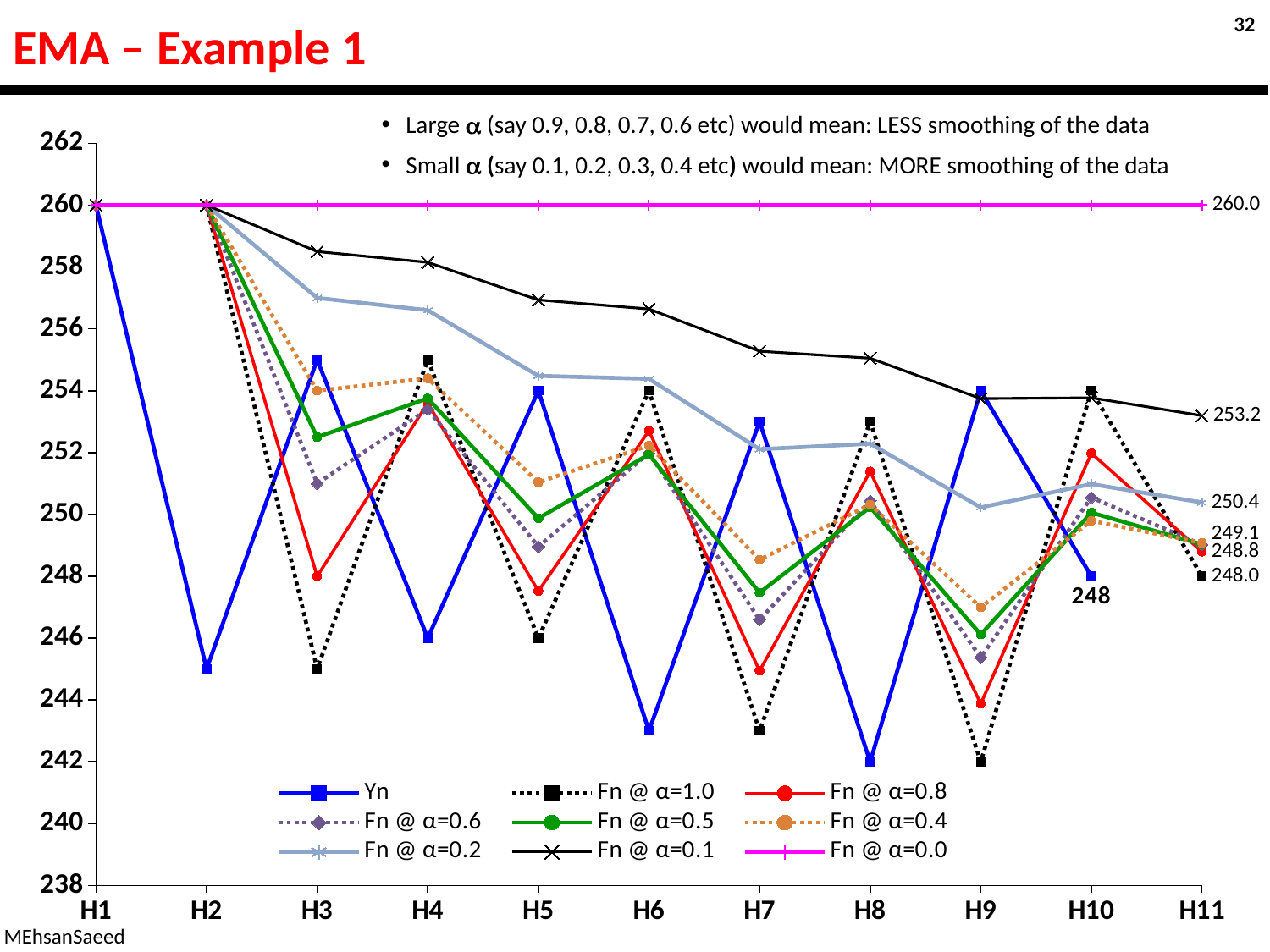
What is the value of Yn at H10? 248 What is the value of Fn @ α=0.2 at H11? 250.4 Does the Fn @ α=0.1 series rise or fall from H2 to H11? fall Is the value of Yn at H2 greater or less than 246? less What is the difference between Fn @ α=0.0 and Fn @ α=0.1 at H11? 6.8 What is the value of Fn @ α=0.0 at H11? 260.0 Which series has the highest value at H11? Fn @ α=0.0 What is the value of Fn @ α=0.1 at H11? 253.2 What type of chart is shown on the slide? line chart What is the value of Fn @ α=1.0 at H11? 248.0 How many categories are on the x axis? 11 How many series does the legend list? 9